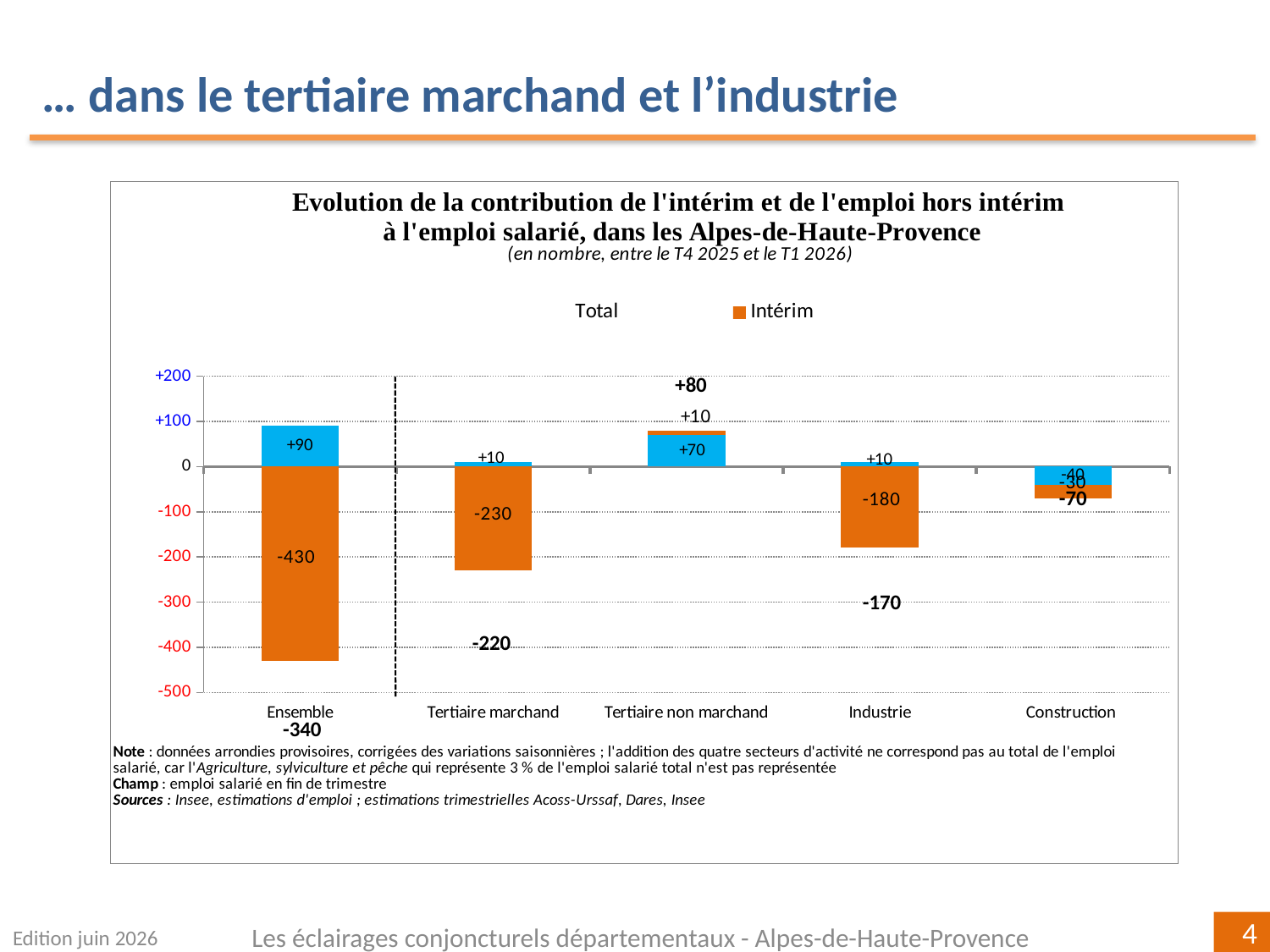
What is the Total value shown for Tertiaire non marchand? +80 What is the Total value shown for Tertiaire marchand? -220 What is the Intérim value for Industrie? -180 What is the Total value shown for Ensemble? -340 What colour are the Intérim bars in the chart? orange What is the difference between the Intérim value for Ensemble and the Intérim value for Tertiaire marchand? 200 What is the Intérim value for Ensemble? -430 How many categories are shown on the x axis of the chart? 5 Which category has the highest Total value? Tertiaire non marchand What is the Total value shown for Construction? -70 What kind of chart is shown on the slide? bar chart Among the four sectors (excluding Ensemble), which has the lowest Intérim value? Tertiaire marchand